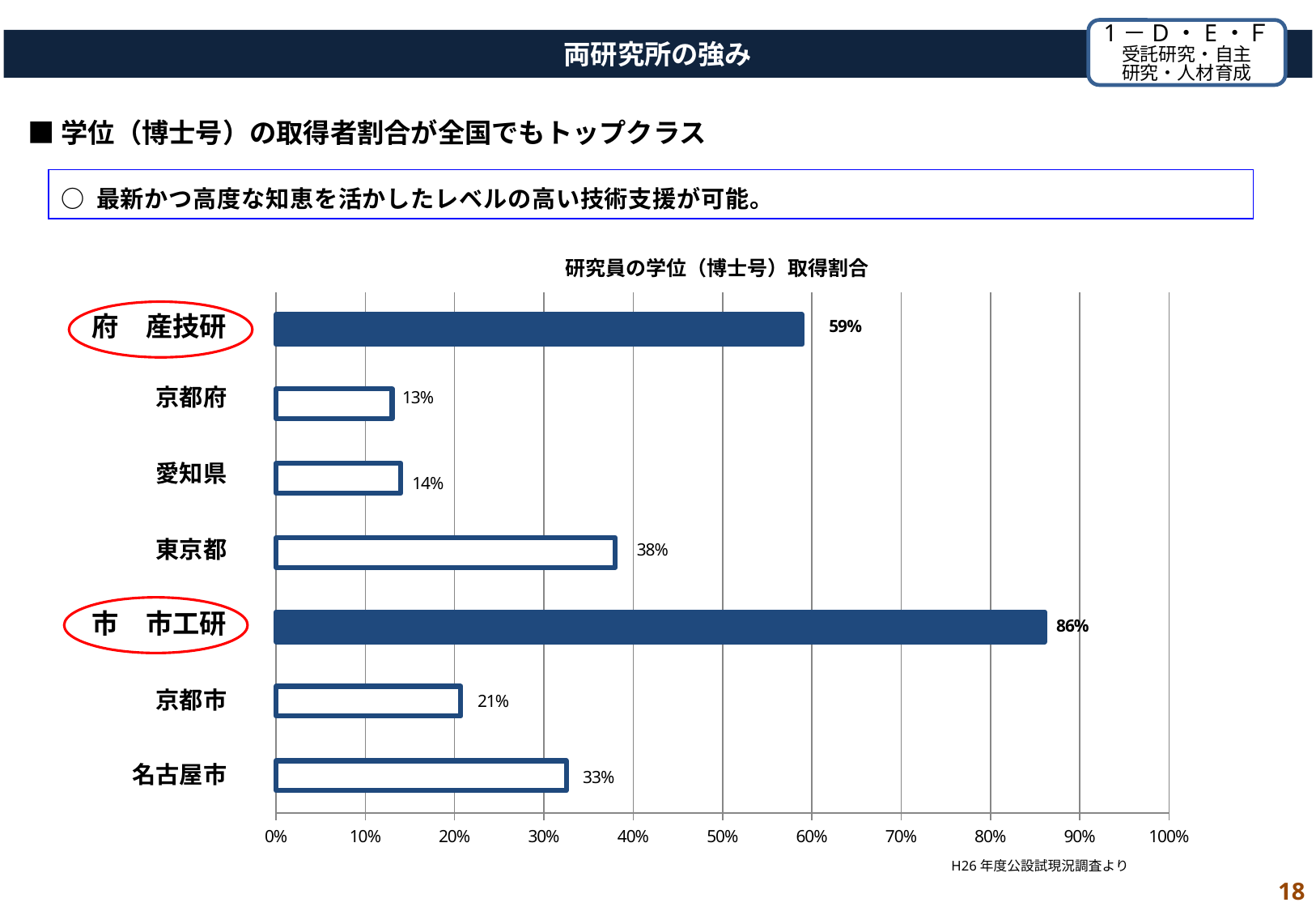
What is the value for 名古屋市? 33% What is the difference between the values for 市 市工研 and 府 産技研? 27% Which category has the lowest value? 京都府 What kind of chart is shown on the slide? Bar chart How many categories are shown in the chart? 7 Which category has the highest value? 市 市工研 What is the value for 市 市工研? 86% What is the difference between the values for 東京都 and 京都市? 17% What is the value for 東京都? 38% What is the title of the chart? 研究員の学位（博士号）取得割合 What is the value for 府 産技研 in the chart 研究員の学位（博士号）取得割合? 59% Which is larger, the value for 愛知県 or the value for 京都市? 京都市